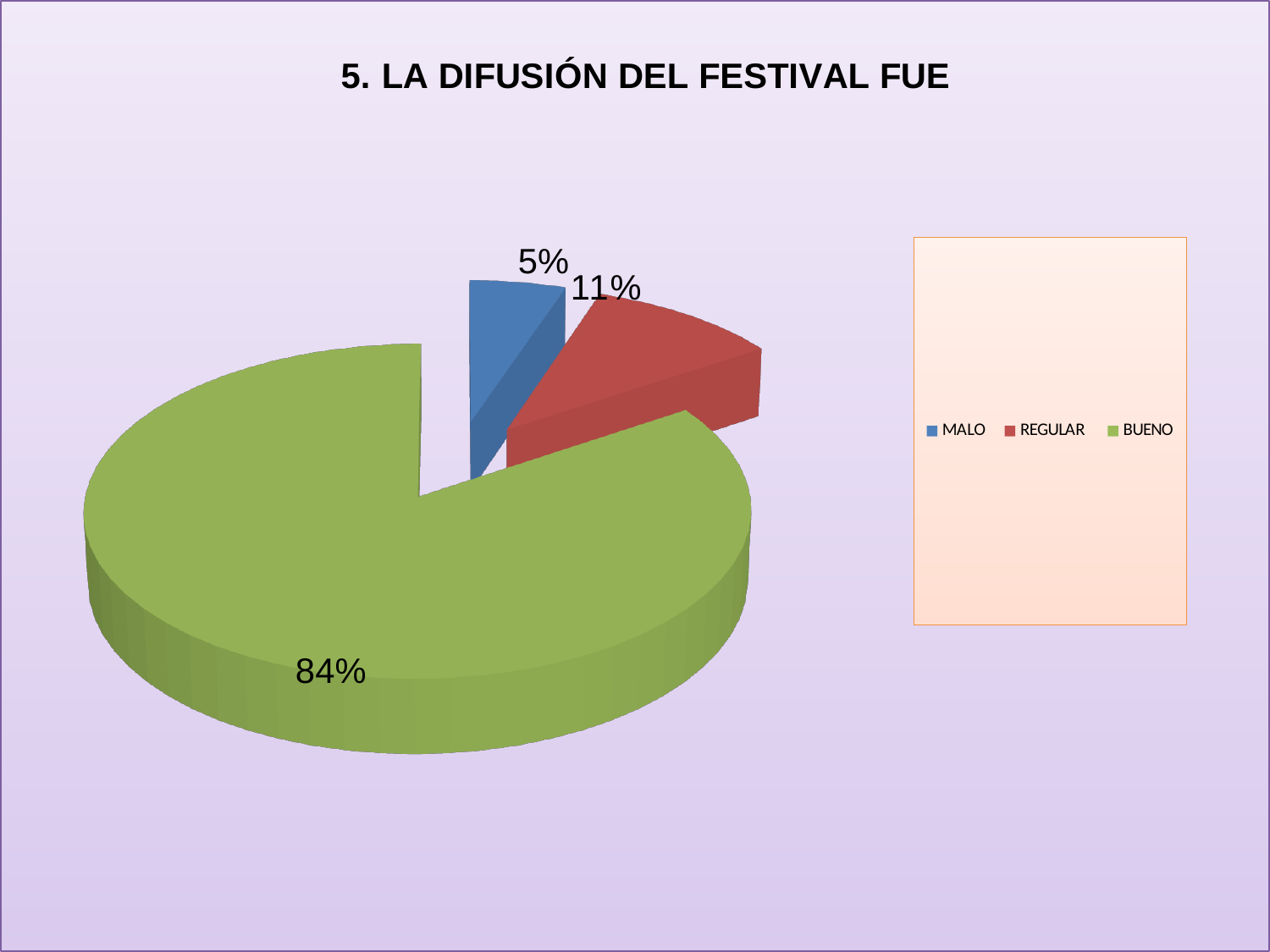
How many categories does the pie chart show? 3 What is the difference between the BUENO and REGULAR percentages? 73% Which category has the largest slice? BUENO What share of the pie does BUENO represent? 84% What kind of chart is shown on the slide? Pie chart What is the difference between the REGULAR and MALO percentages? 6% Which colour represents REGULAR in the legend? Red Which is larger, REGULAR or MALO? REGULAR Which category has the smallest slice? MALO What is the value shown for REGULAR? 11% What is the value shown for MALO? 5% What is the title of the chart? 5. LA DIFUSIÓN DEL FESTIVAL FUE